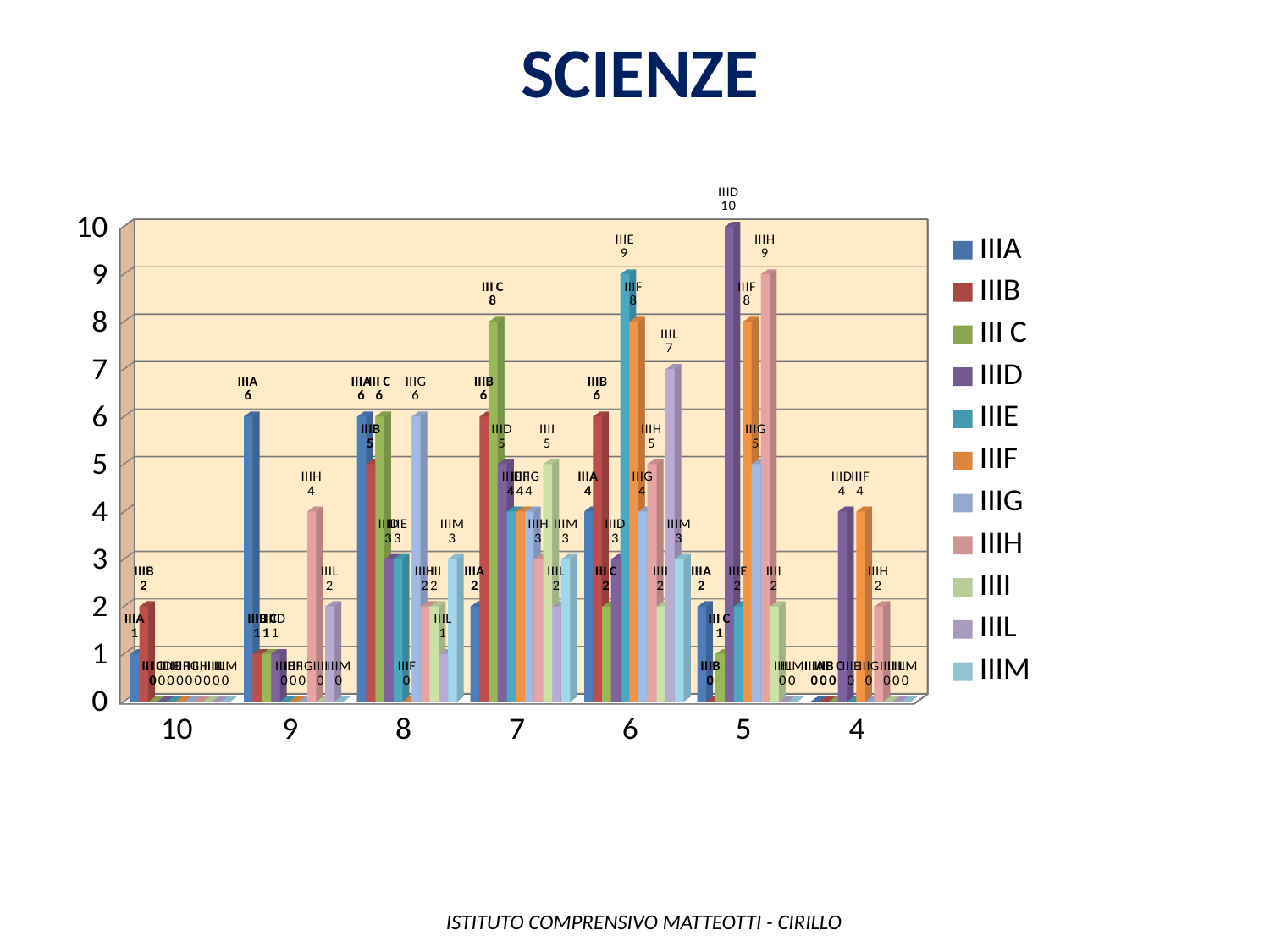
What is the value for IIIE at category 6? 9 How many series does the legend list? 11 What is the value for III C at category 7? 8 What kind of chart is shown on the slide? Bar chart Which series has the highest value at category 5? IIID What is the difference between the values for IIIE and IIIF at category 6? 1 How many categories are shown on the x axis? 7 Which series has the highest value at category 9? IIIA What is the value for IIID at category 5? 10 What is the value for IIIH at category 5? 9 At category 9, which is larger: the value for IIIA or the value for IIIH? IIIA What is the value for IIIL at category 6? 7